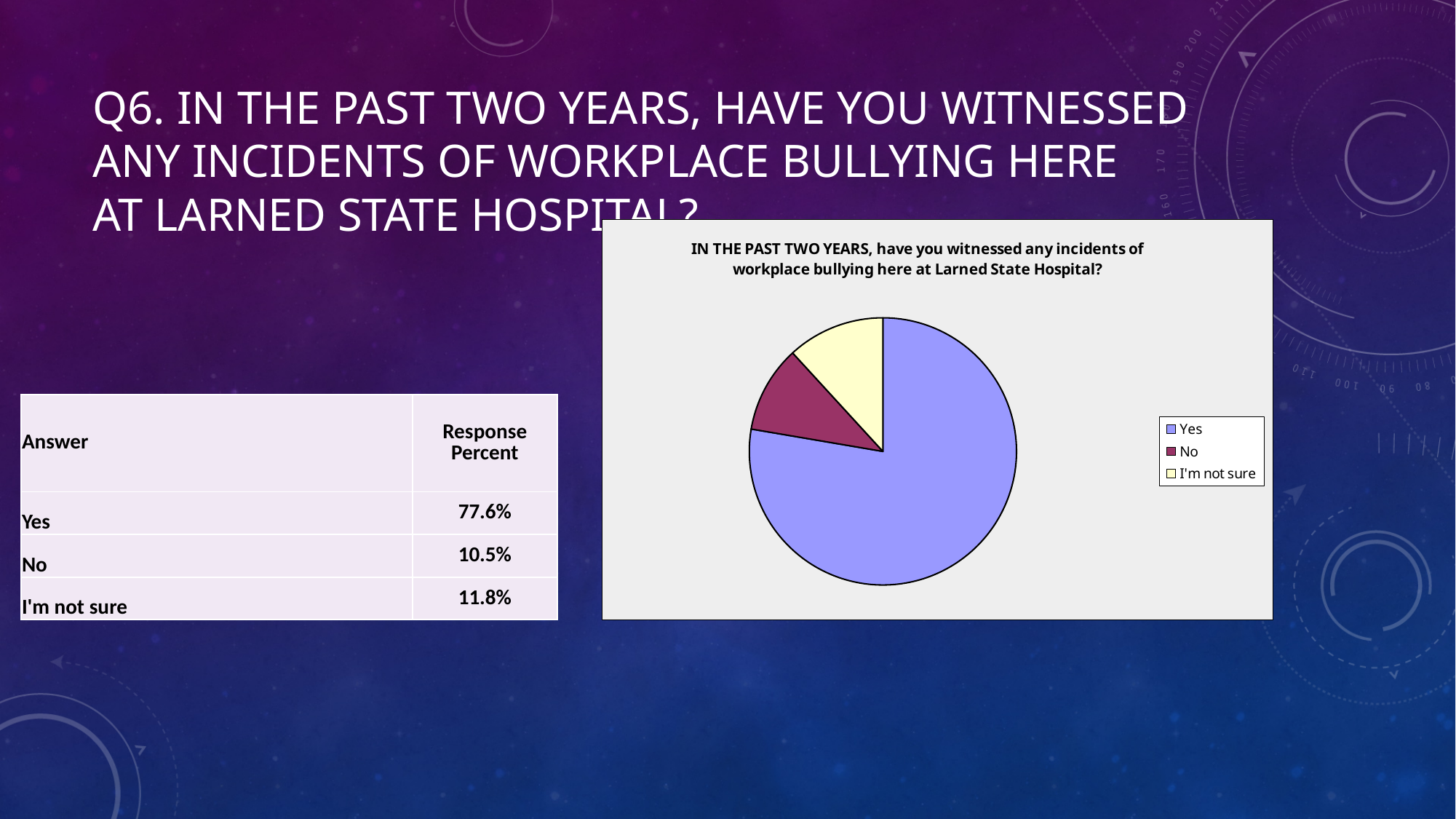
What is the response percent for "No"? 10.5% What is the response percent for "I'm not sure"? 11.8% Which colour represents "No" in the pie chart? dark red What kind of chart is shown on the slide? pie chart How many slices does the pie chart have? 3 What is the difference in response percent between "Yes" and "No"? 67.1% What share of the pie does the "Yes" slice represent? 77.6% What is the response percent for "Yes"? 77.6% Which is larger, the share for "No" or the share for "I'm not sure"? I'm not sure Which answer has the smallest share of the pie? No How many entries does the pie chart's legend list? 3 Which answer has the largest share of the pie? Yes